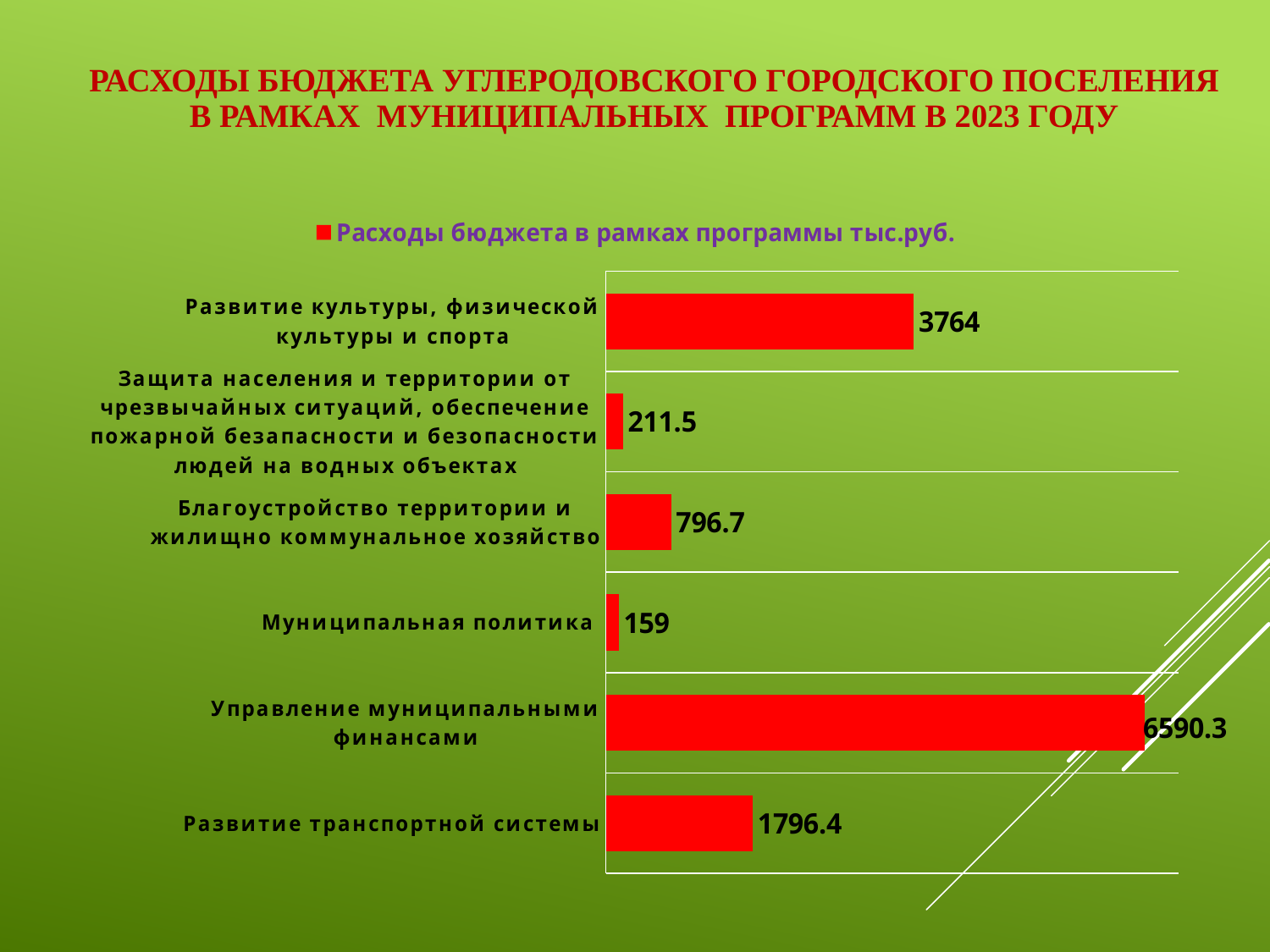
Which category has the lowest value? Муниципальная политика What kind of chart is shown on the slide? Bar chart Which category has the highest value? Управление муниципальными финансами What is the difference between «Развитие транспортной системы» and «Благоустройство территории и жилищно коммунальное хозяйство»? 999.7 How many categories are shown in the chart? 6 What is the value for «Развитие культуры, физической культуры и спорта»? 3764 What is the value for «Муниципальная политика»? 159 What is the legend entry of the chart? Расходы бюджета в рамках программы тыс.руб. What is the difference between «Управление муниципальными финансами» and «Развитие культуры, физической культуры и спорта»? 2826.3 What is the value for «Управление муниципальными финансами»? 6590.3 What is the value for «Развитие транспортной системы»? 1796.4 Which is larger: «Защита населения и территории от чрезвычайных ситуаций...» or «Благоустройство территории и жилищно коммунальное хозяйство»? Благоустройство территории и жилищно коммунальное хозяйство